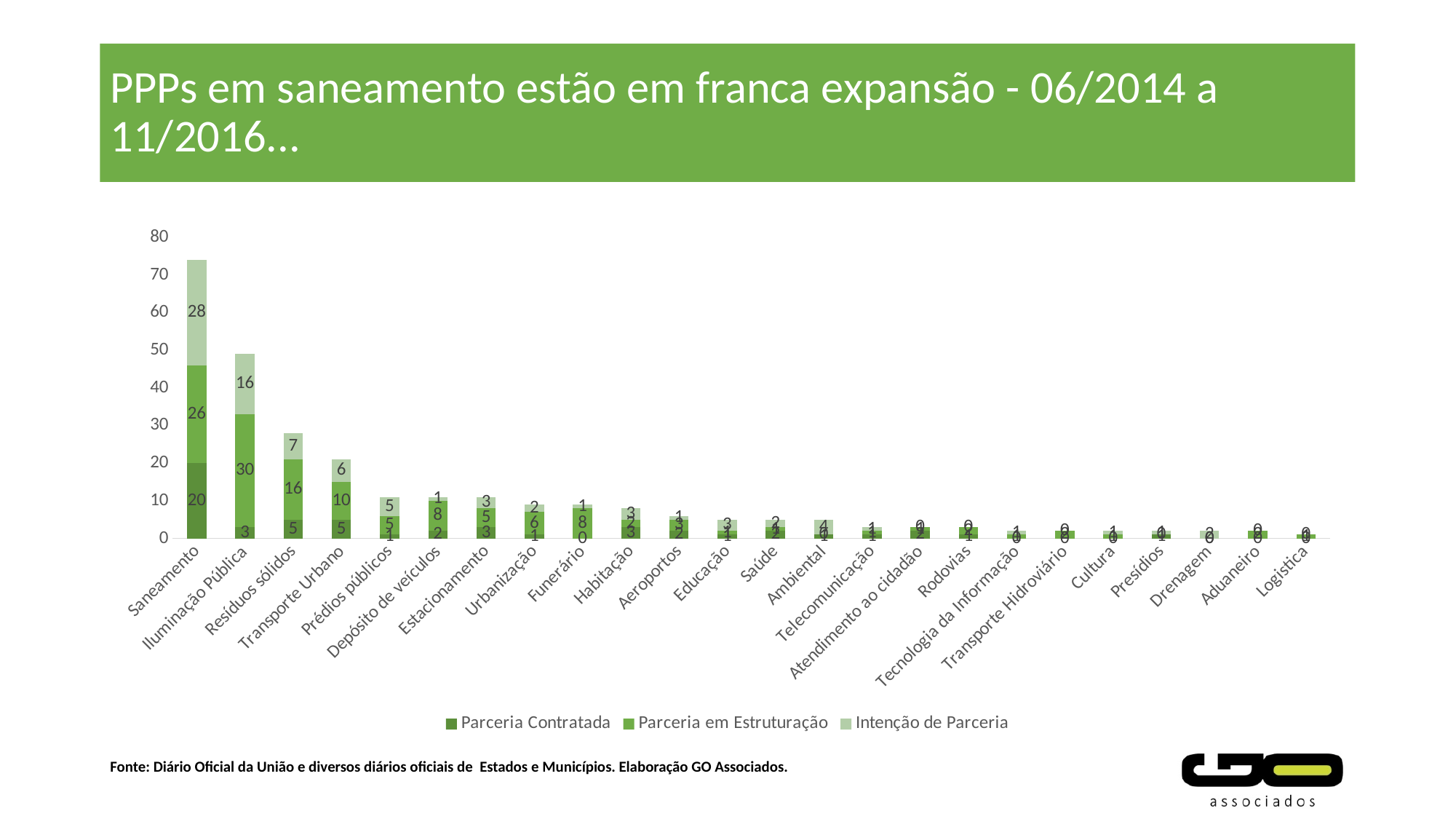
How many series does the legend list? 3 Which is larger: the Parceria Contratada value for Saneamento or for Iluminação Pública? Saneamento Which series is shown in the lightest green in the legend? Intenção de Parceria What is the Intenção de Parceria value for Saneamento? 28 What is the Parceria Contratada value for Resíduos sólidos? 5 What is the Parceria em Estruturação value for Iluminação Pública? 30 Which category has the highest total stacked bar? Saneamento What is the total of the stacked bar for Transporte Urbano? 21 What is the total of the stacked bar for Saneamento? 74 How many categories are shown on the x axis? 24 What is the difference between the Parceria em Estruturação values for Iluminação Pública and Resíduos sólidos? 14 What kind of chart is shown on the slide? stacked bar chart